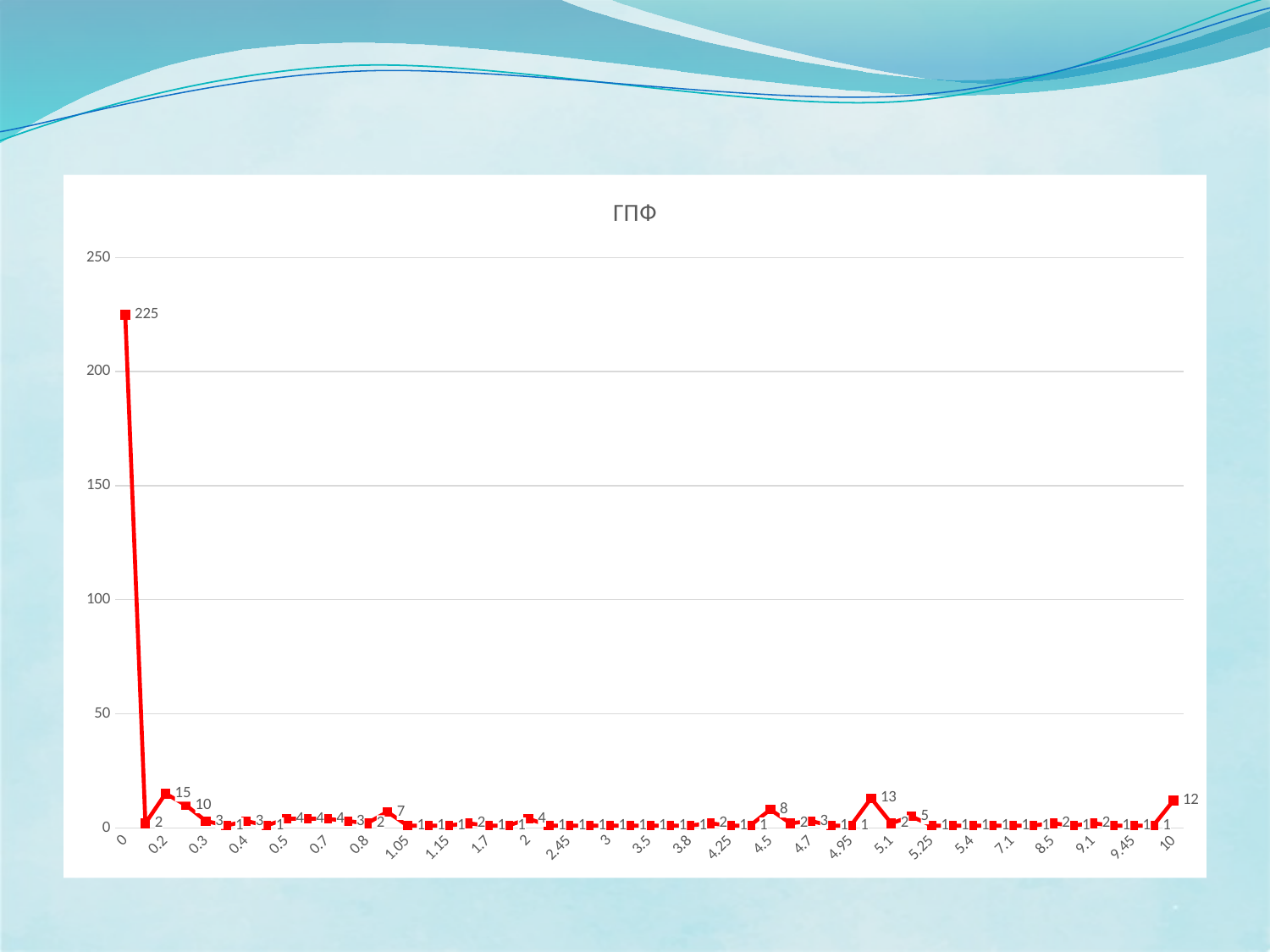
Is the value at x = 0 greater or less than 200? greater Is the value at x = 4.5 greater or less than 50? less What is the difference between the value at x = 0 and the value at x = 10? 213 What is the value at x = 0.2? 15 What is the value at x = 10? 12 At which x value does the line reach its highest point? 0 What kind of chart is shown on the slide? line chart Which is larger, the value at x = 0.2 or the value at x = 10? x = 0.2 What is the value at x = 4.5? 8 What is the value at x = 0? 225 What is the title of the chart? ГПФ What colour is the line in the chart? red